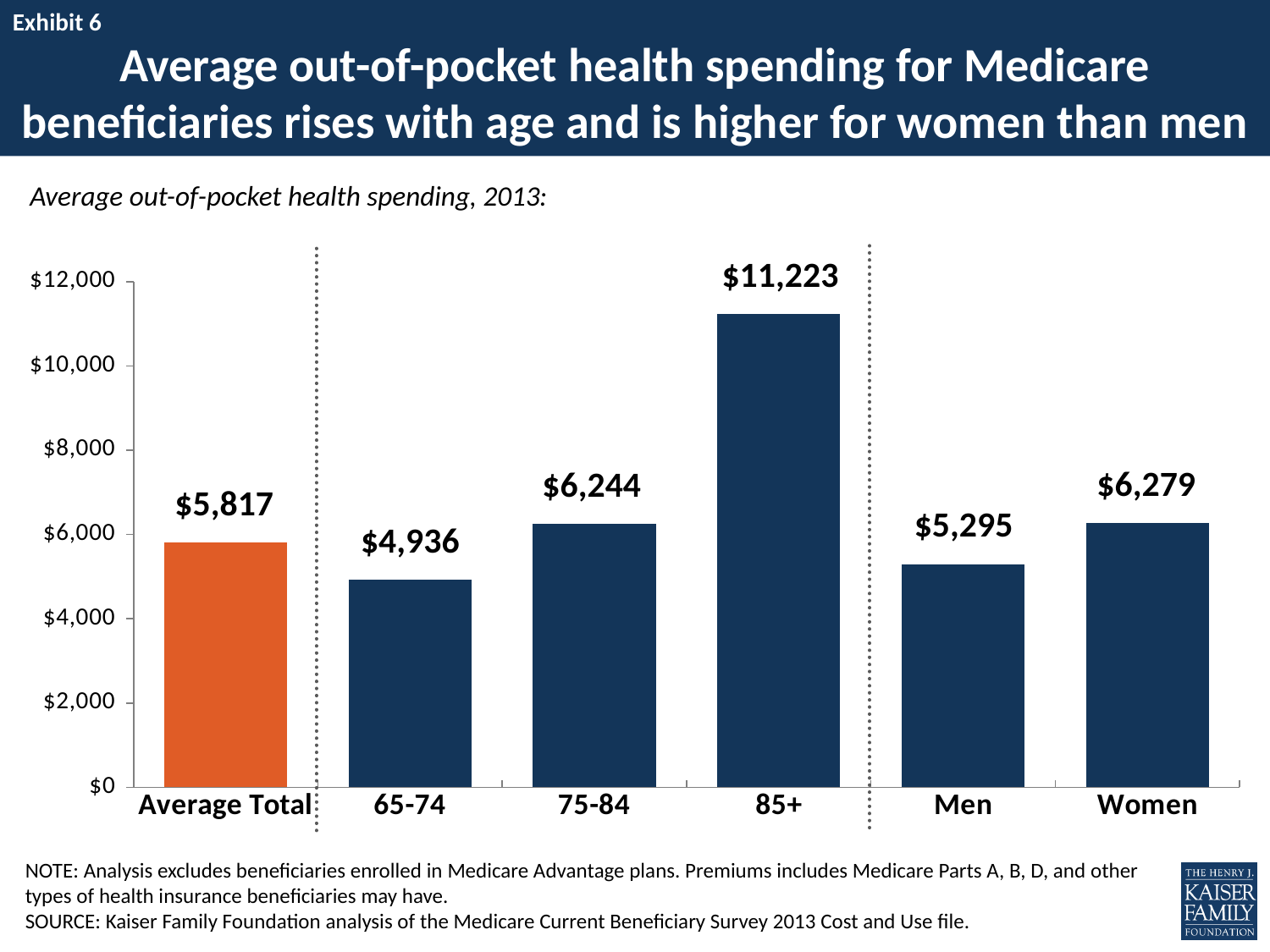
Which category has the lowest average out-of-pocket health spending? 65-74 Do the values rise or fall across the age groups from 65-74 to 85+? Rise What is the value shown for Average Total? $5,817 What is the average out-of-pocket health spending for the 85+ age group? $11,223 Which has higher average out-of-pocket spending, the 75-84 age group or Men? 75-84 What type of chart is shown on the slide? Bar chart How many bars are shown in the chart? 6 What is the difference in average out-of-pocket spending between the 85+ and 75-84 age groups? $4,979 Which category has the highest average out-of-pocket health spending? 85+ Is the value for the 65-74 age group greater or less than $6,000? less What is the difference in average out-of-pocket spending between Women and Men? $984 What is the average out-of-pocket health spending for Women? $6,279